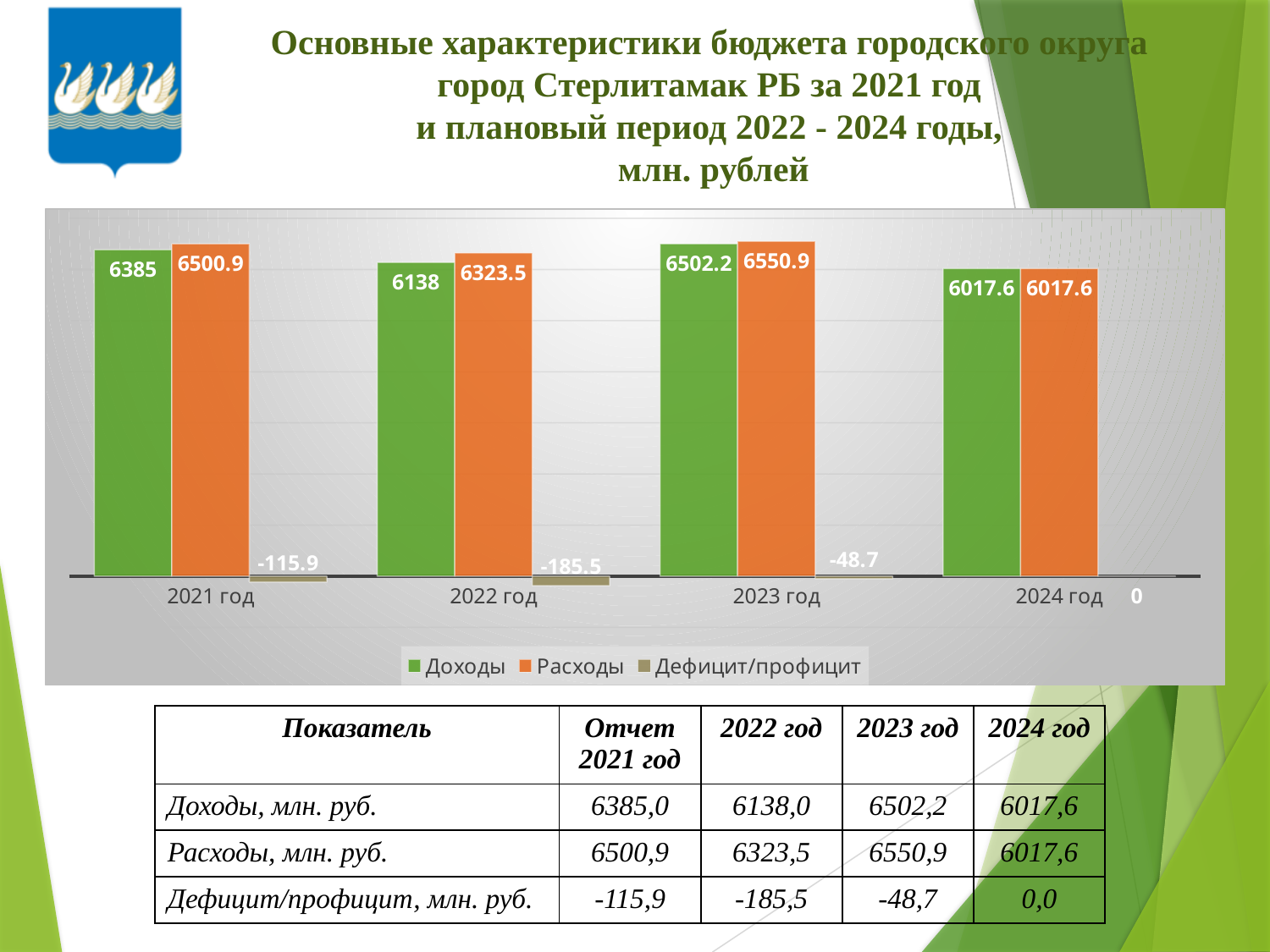
How many series does the chart legend list? 3 How many year categories are shown on the x axis of the chart? 4 What is the value of Расходы for 2023 год in the chart? 6550.9 What is the value of Дефицит/профицит for 2024 год in the chart? 0 What type of chart is shown on the slide? bar chart Which is larger in the chart for 2021 год: Доходы or Расходы? Расходы In which year is Расходы highest in the chart? 2023 год Which series in the chart is shown in orange? Расходы What is the difference between Расходы and Доходы for 2022 год in the chart? 185.5 In which year is Доходы lowest in the chart? 2024 год What is the value of Дефицит/профицит for 2022 год in the chart? -185.5 What is the value of Доходы for 2021 год in the chart? 6385